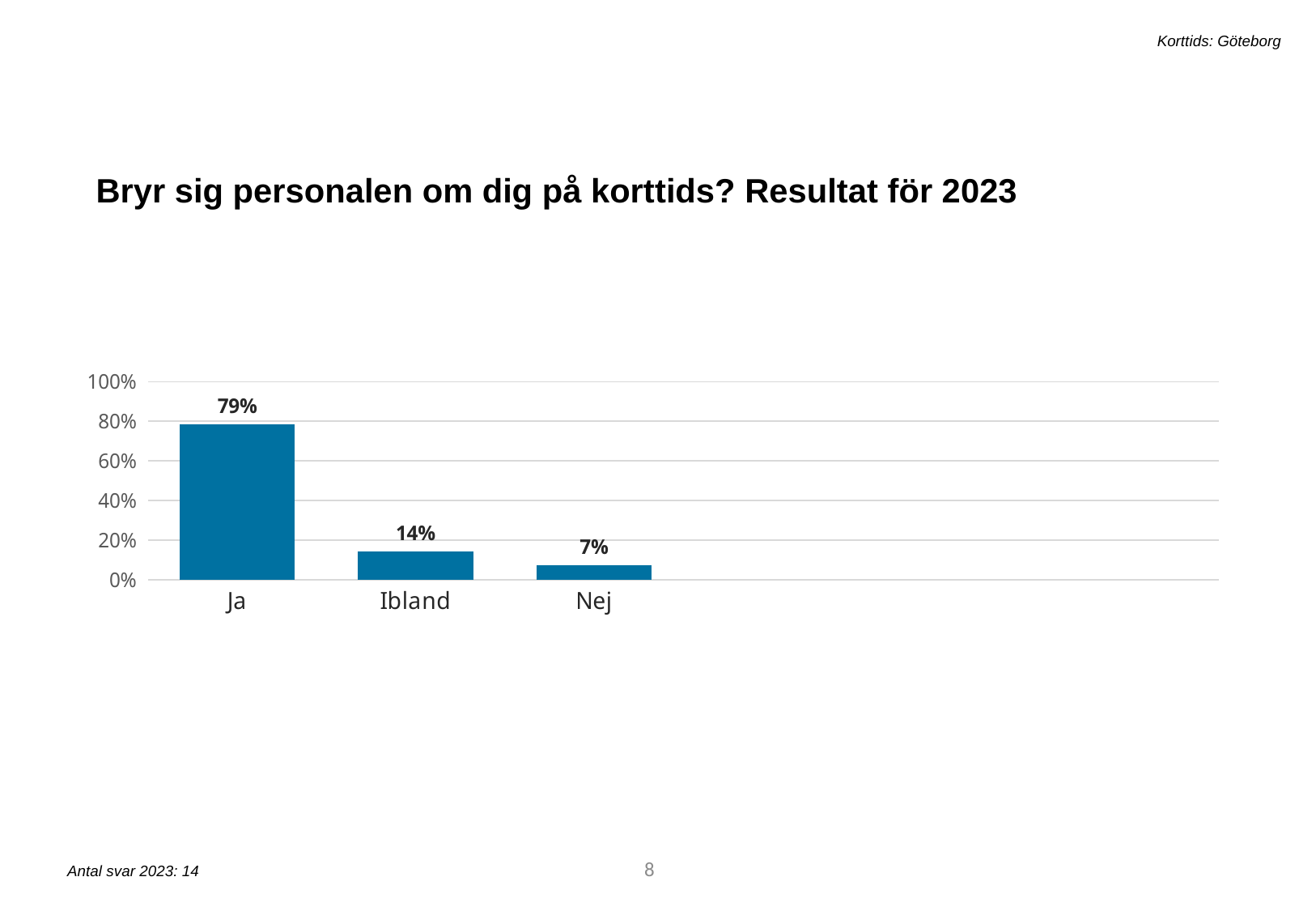
What is the value for Ibland? 14% What is the difference between the values for Ja and Ibland? 65% Which is larger, the value for Ibland or the value for Nej? Ibland What is the title of the slide? Bryr sig personalen om dig på korttids? Resultat för 2023 How many categories are shown on the x axis? 3 Which category has the lowest value? Nej Which category has the highest value? Ja What kind of chart is shown on the slide? bar chart What is the value for Nej? 7% What is the difference between the values for Ibland and Nej? 7% Is the value for Ja greater or less than 60%? greater What is the value for Ja? 79%